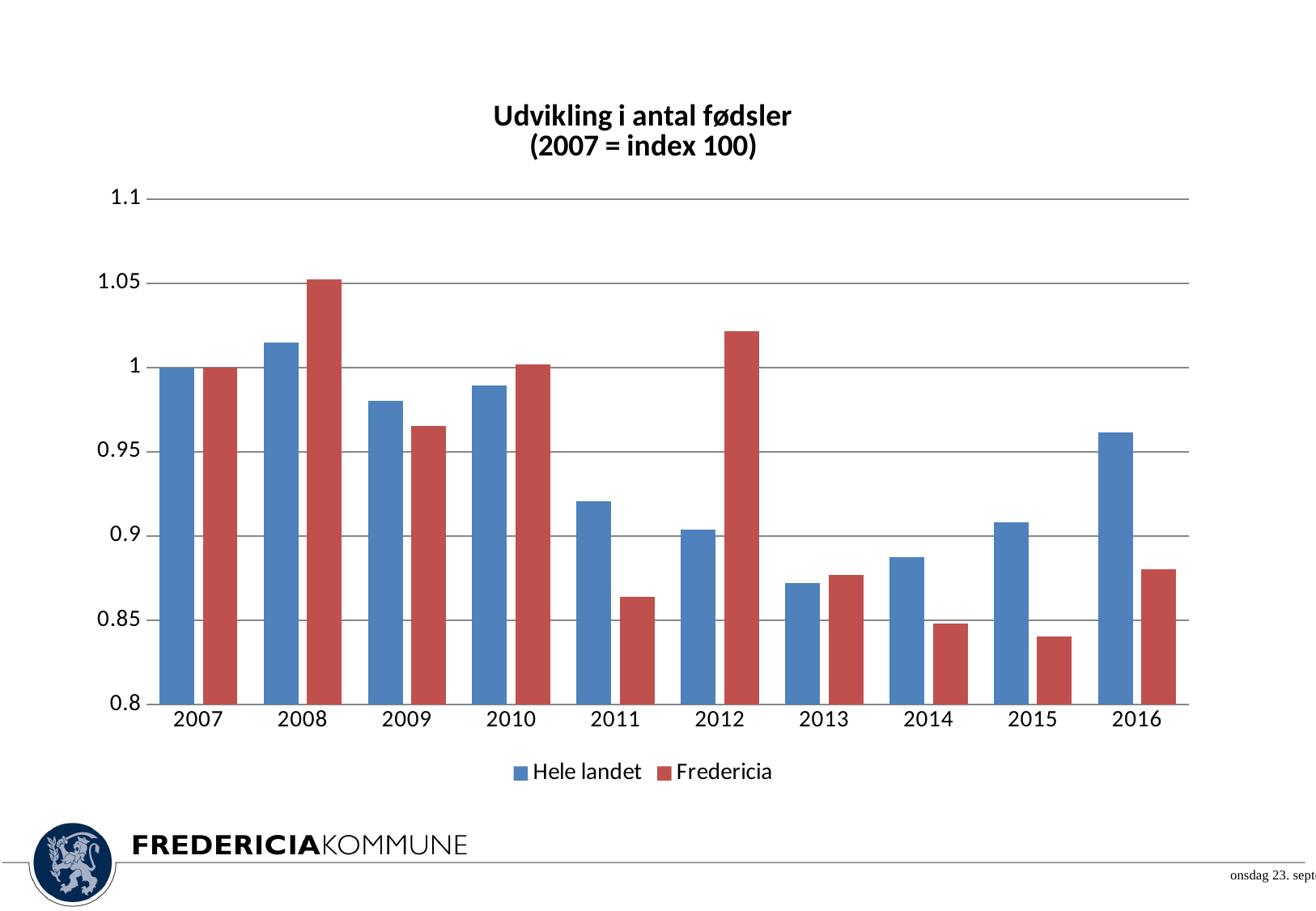
In which year is the Fredericia value highest? 2008 What is the title of the chart? Udvikling i antal fødsler (2007 = index 100) What is the value for Fredericia in 2007? 1 Is the value for Fredericia in 2015 greater or less than 0.85? less In 2012, which series has the larger value, Hele landet or Fredericia? Fredericia In which year is the Hele landet value lowest? 2013 What kind of chart is shown on the slide? bar chart How many series does the legend list? 2 Is the value for Hele landet in 2016 greater or less than 0.95? greater How many years are shown on the x axis? 10 What is the value for Hele landet in 2007? 1 Do the Fredericia values rise or fall from 2012 to 2015? fall